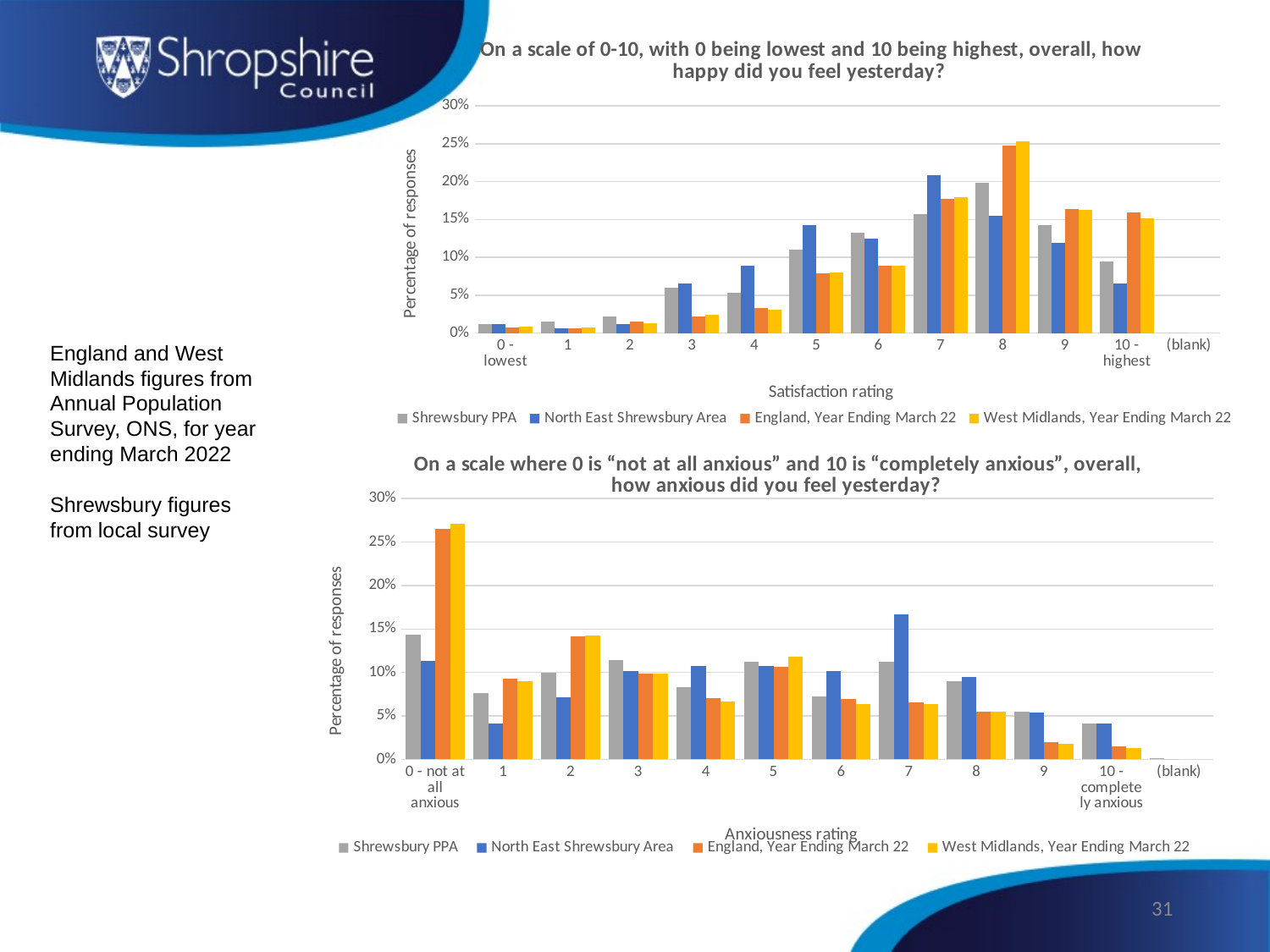
What kind of chart is the top chart about how happy people felt yesterday? bar chart In the top chart (happiness), is the England, Year Ending March 22 value at rating 8 greater or less than 20%? greater How many series does the legend of the top chart (happiness) list? 4 What is the x-axis title of the bottom chart? Anxiousness rating In the top chart (happiness), at which satisfaction rating is the England, Year Ending March 22 value highest? 8 In the bottom chart (anxiousness), at which rating is the West Midlands, Year Ending March 22 value highest? 0 - not at all anxious In the bottom chart (anxiousness), which series has the highest value at rating 7? North East Shrewsbury Area In the top chart (happiness), which series has the lowest value at the '10 - highest' rating? North East Shrewsbury Area In the top chart (happiness), at rating 5, which is larger: Shrewsbury PPA or North East Shrewsbury Area? North East Shrewsbury Area In the bottom chart (anxiousness), is the England, Year Ending March 22 value at '0 - not at all anxious' greater or less than 20%? greater In the top chart (happiness), is the North East Shrewsbury Area value at rating 7 greater or less than 15%? greater How many categories are shown on the x axis of the bottom chart (anxiousness)? 12